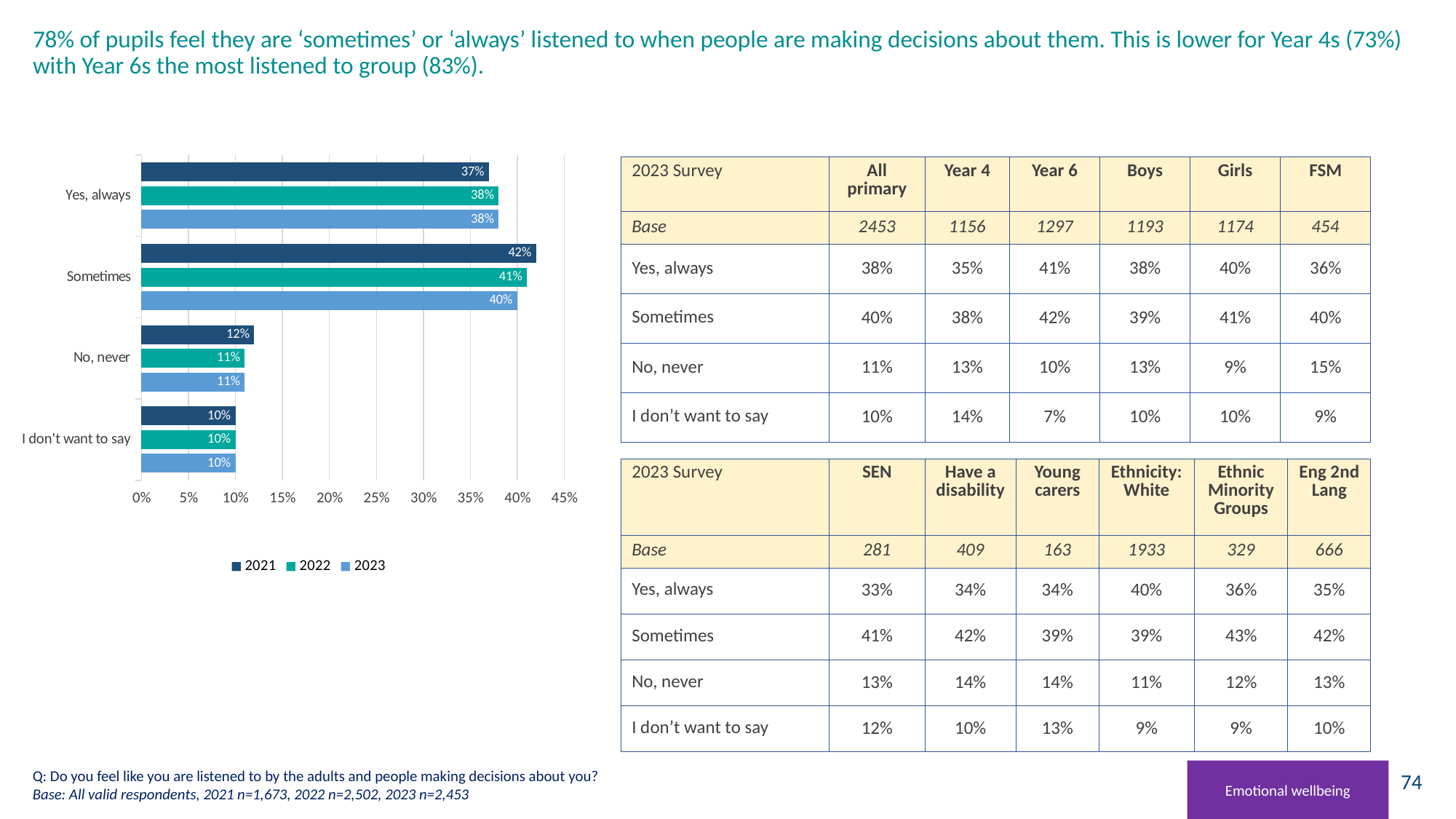
Which category has the lowest 2023 value in the bar chart? I don't want to say How many response categories are shown in the bar chart? 4 In the bar chart, is the 2021 value for 'No, never' larger or smaller than the 2021 value for 'I don't want to say'? larger How many series does the legend of the bar chart list? 3 Which category has the highest 2021 value in the bar chart? Sometimes Which years are listed in the legend of the bar chart? 2021, 2022, 2023 What is the 2023 value for 'Sometimes' in the bar chart? 40% Did the value for 'Sometimes' rise or fall from 2021 to 2023 in the bar chart? fall What is the 2021 value for 'Yes, always' in the bar chart? 37% What is the difference between the 2021 and 2023 values for 'Sometimes' in the bar chart? 2% What type of chart is shown on the slide? bar chart What is the 2022 value for 'No, never' in the bar chart? 11%